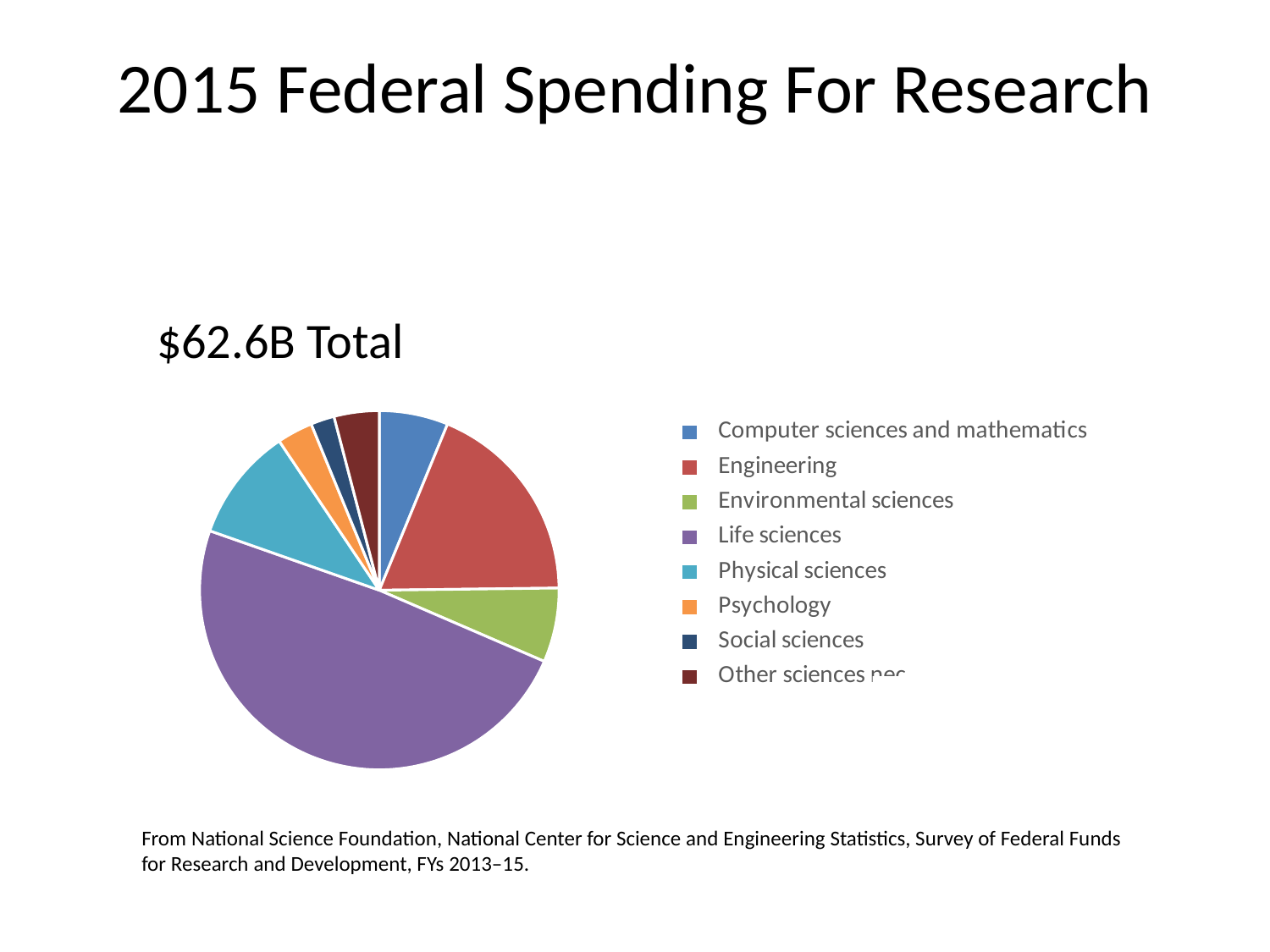
What kind of chart is shown on the slide? Pie chart Which is larger, the slice for Computer sciences and mathematics or the slice for Psychology? Computer sciences and mathematics What total amount is stated above the pie chart? $62.6B Total Which category has the largest slice of the pie? Life sciences How many entries does the legend list? 8 Which is larger, the slice for Physical sciences or the slice for Environmental sciences? Physical sciences Which is larger, the slice for Engineering or the slice for Physical sciences? Engineering What is the title of the slide? 2015 Federal Spending For Research How many slices does the pie chart have? 8